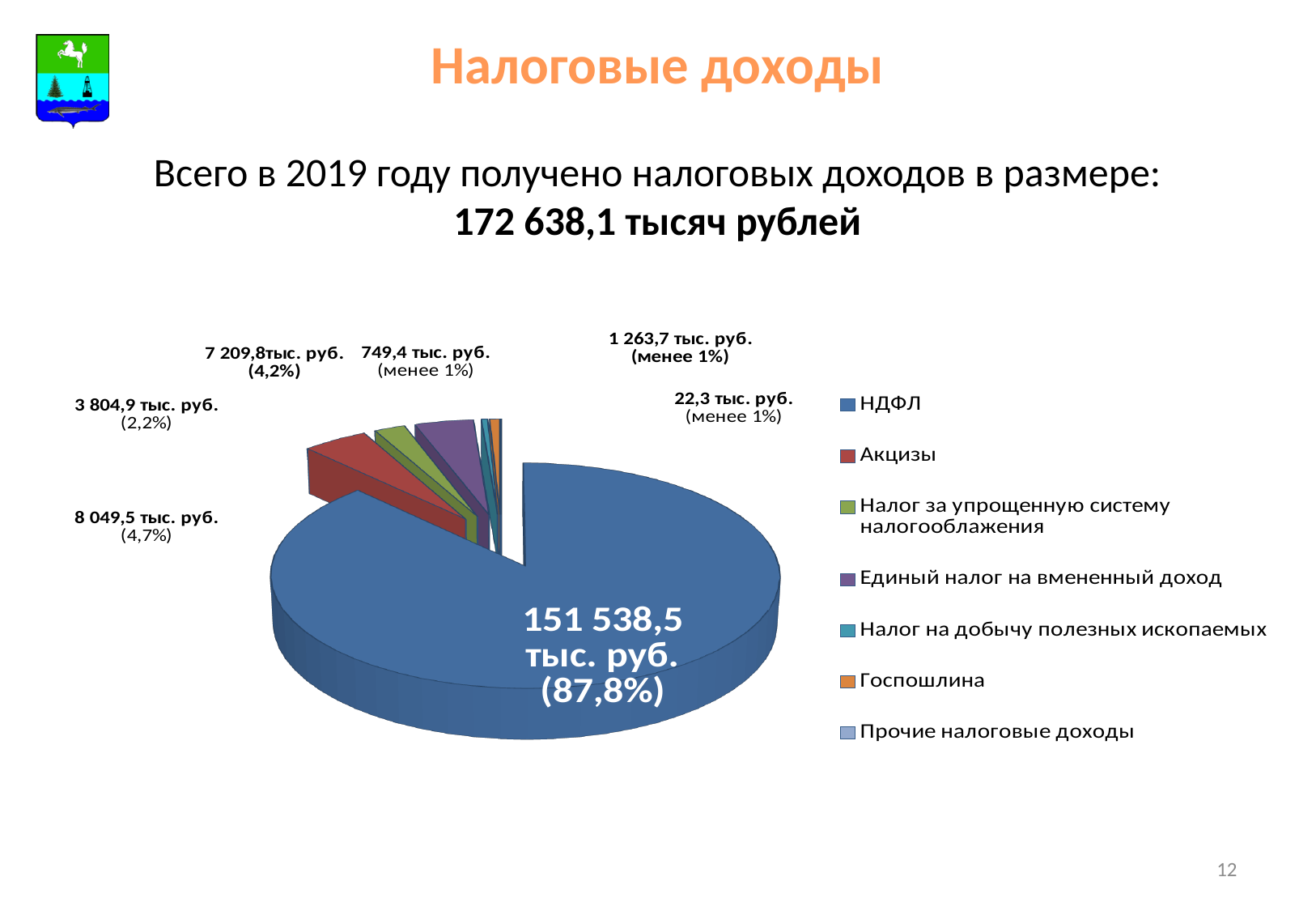
What value is shown for НДФЛ on the pie chart? 151 538,5 тыс. руб. How many slices does the pie chart have? 7 How many entries does the legend of the pie chart list? 7 Which is larger, the value for НДФЛ or the value for Акцизы? НДФЛ What is the smallest value labelled on the pie chart? 22,3 тыс. руб. What share of the pie does НДФЛ account for? 87,8% Which category has the largest slice of the pie chart? НДФЛ What type of chart is shown on the slide? Pie chart What value is shown for Акцизы on the pie chart? 8 049,5 тыс. руб. What percentage share is labelled for the slice worth 7 209,8 тыс. руб.? 4,2% What is the difference between the value for НДФЛ and the value for Акцизы? 143 489,0 тыс. руб. What percentage share is labelled for the slice worth 3 804,9 тыс. руб.? 2,2%